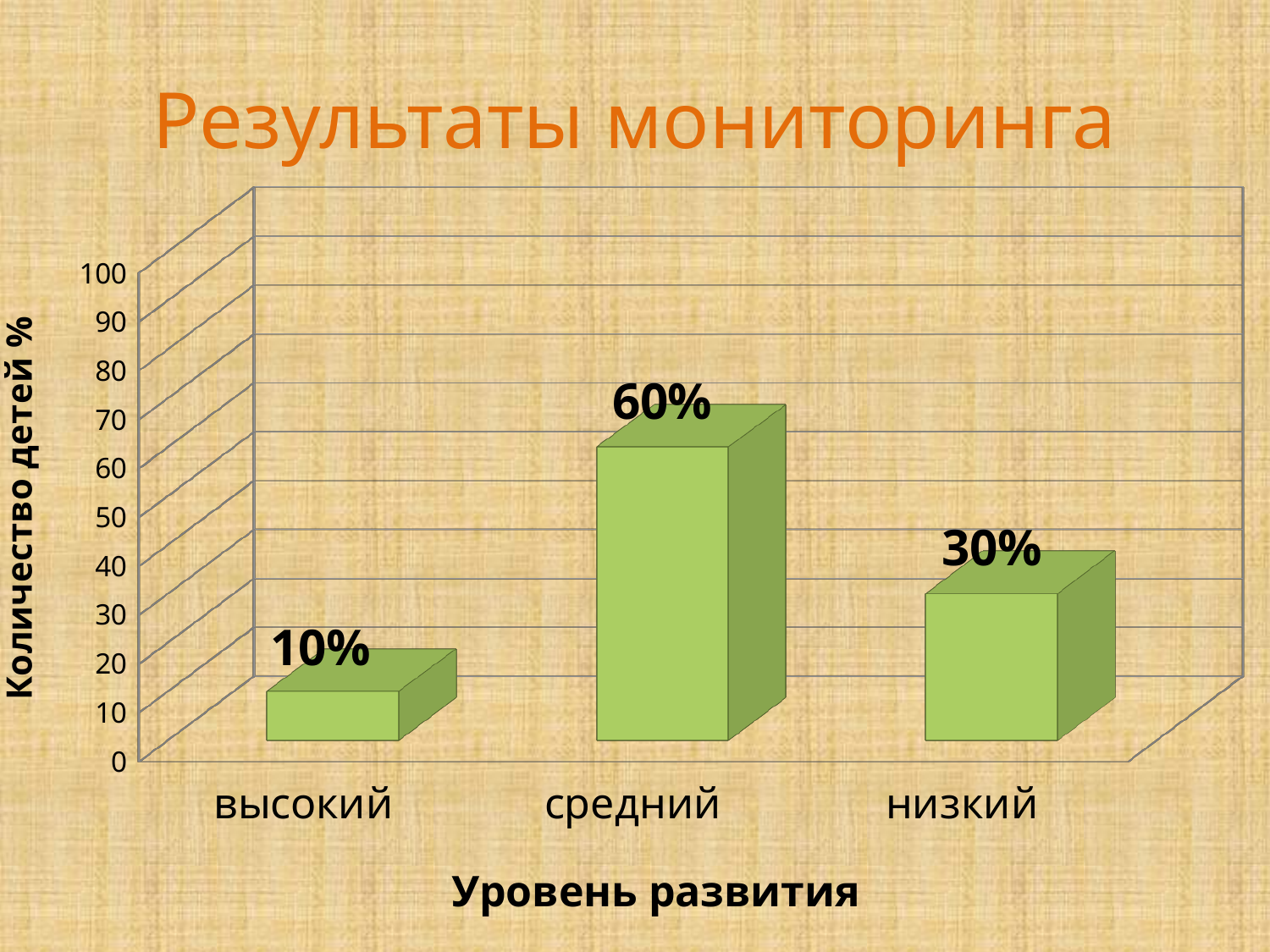
What is the label of the x axis? Уровень развития What is the value for низкий? 30% What is the difference between the values for низкий and высокий? 20% What is the value for средний? 60% Which category has the lowest value? высокий Which is larger, the value for низкий or the value for высокий? низкий What kind of chart is shown on the slide? bar chart Is the value for средний greater or less than 50? greater What is the value for высокий? 10% How many categories are shown on the x axis? 3 Which category has the highest value? средний What is the difference between the values for средний and низкий? 30%